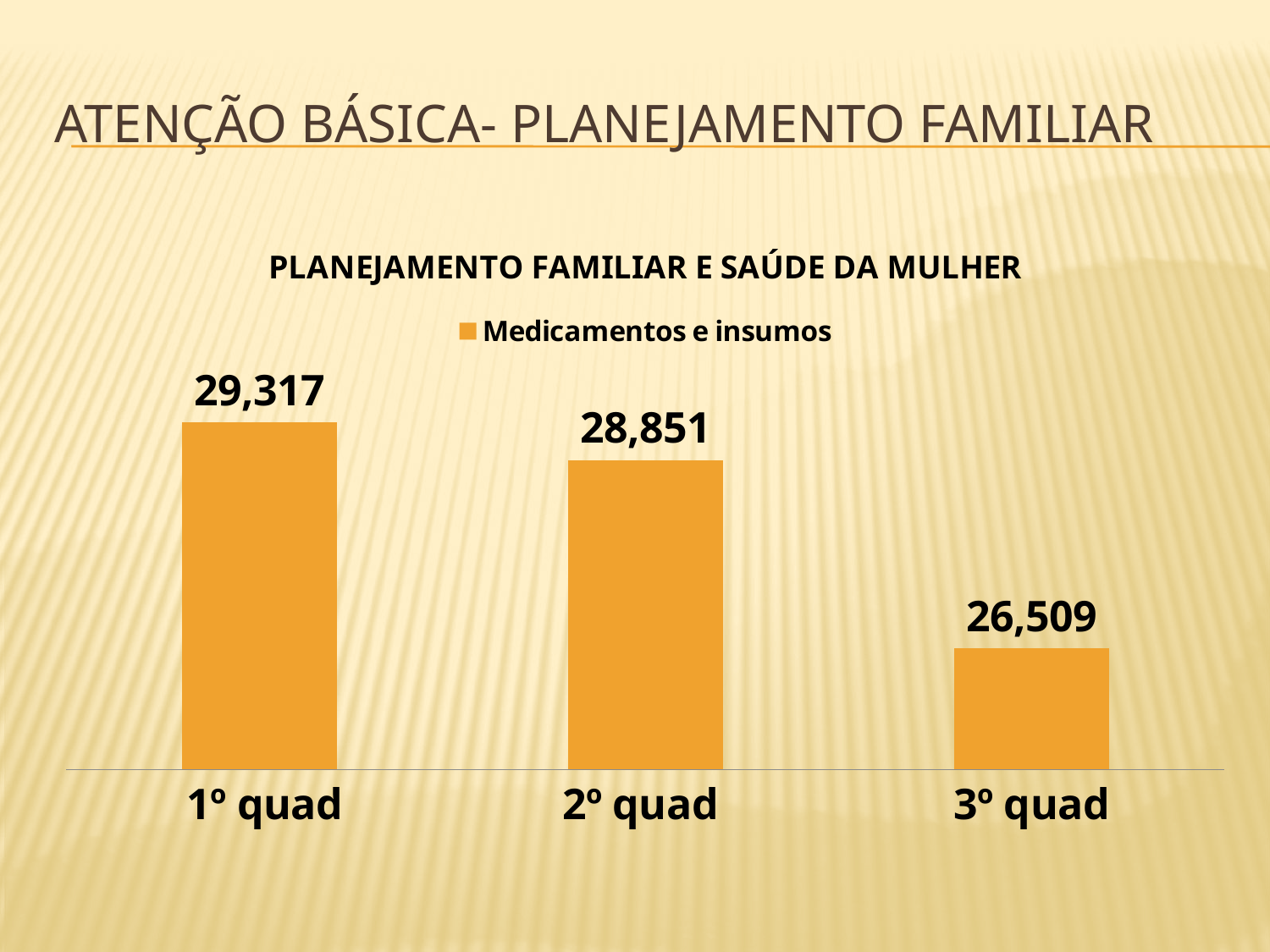
What is the difference between the values for 1º quad and 2º quad? 466 What is the value for 1º quad? 29,317 What is the difference between the values for 1º quad and 3º quad? 2,808 What kind of chart is shown? bar chart Which category has the lowest value? 3º quad How many series does the legend list? 1 Which category has the highest value? 1º quad What is the value for 3º quad? 26,509 Which is larger, the value for 2º quad or the value for 3º quad? 2º quad What is the value for 2º quad? 28,851 Do the values rise or fall from 1º quad to 3º quad? fall How many categories are shown on the x axis? 3